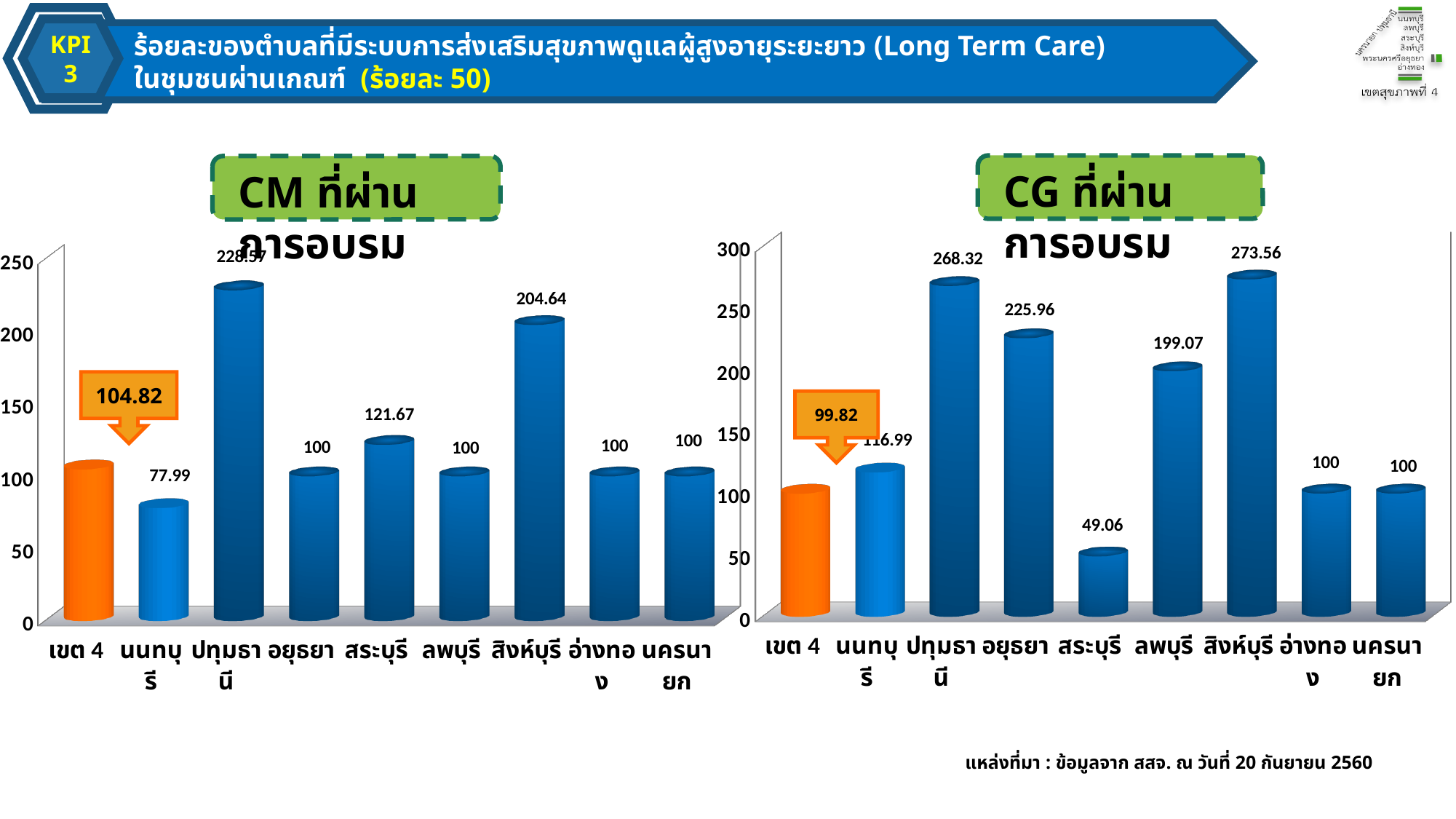
In the CG ที่ผ่านการอบรม chart, what is the value for สระบุรี? 49.06 In the CG ที่ผ่านการอบรม chart, what is the difference between สิงห์บุรี and ปทุมธานี? 5.24 In the CM ที่ผ่านการอบรม chart, what is the value for สิงห์บุรี? 204.64 How many categories are shown on the x axis of the CG ที่ผ่านการอบรม chart? 9 In the CM ที่ผ่านการอบรม chart, what value is shown in the callout for เขต 4? 104.82 In the CM ที่ผ่านการอบรม chart, what is the value for นนทบุรี? 77.99 What type of chart is the CM ที่ผ่านการอบรม chart? Bar chart In the CM ที่ผ่านการอบรม chart, which province has the lowest value? นนทบุรี In the CG ที่ผ่านการอบรม chart, what is the value for ปทุมธานี? 268.32 In the CG ที่ผ่านการอบรม chart, which is larger, อยุธยา or ลพบุรี? อยุธยา In the CM ที่ผ่านการอบรม chart, which province has the highest value? ปทุมธานี In the CG ที่ผ่านการอบรม chart, which province has the highest value? สิงห์บุรี